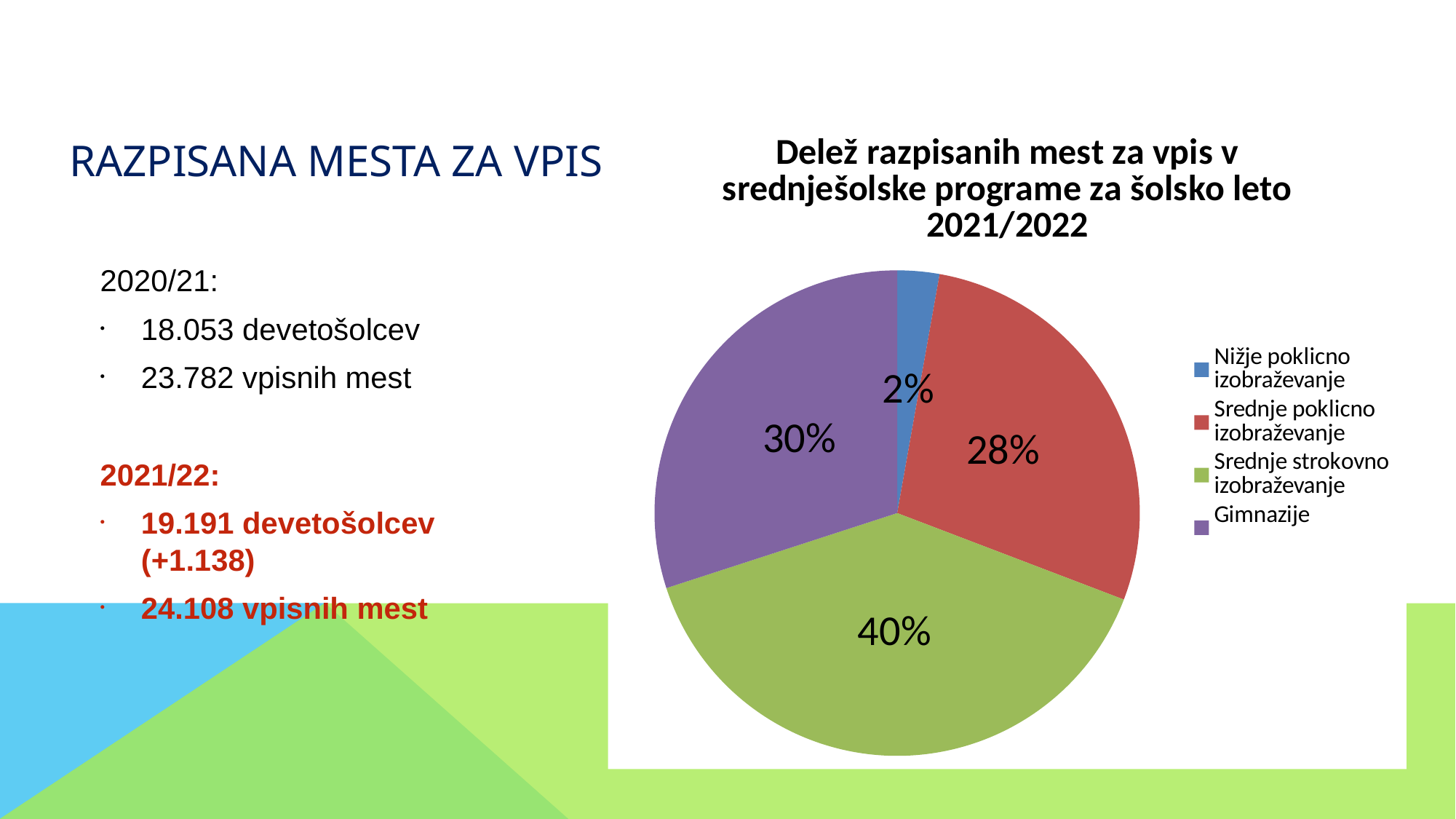
What is the difference in percentage points between Srednje strokovno izobraževanje and Gimnazije? 10 What share of the pie does Srednje poklicno izobraževanje have? 28% What kind of chart is shown on the slide? Pie chart What is the title of the chart? Delež razpisanih mest za vpis v srednješolske programe za šolsko leto 2021/2022 What share of the pie does Gimnazije have? 30% How many categories does the pie chart show? 4 What share of the pie does Nižje poklicno izobraževanje have? 2% What share of the pie does Srednje strokovno izobraževanje have? 40% Which category has the largest slice of the pie? Srednje strokovno izobraževanje Which is larger, the share for Gimnazije or the share for Srednje poklicno izobraževanje? Gimnazije Which category has the smallest slice of the pie? Nižje poklicno izobraževanje Which colour represents Gimnazije in the pie chart? Purple